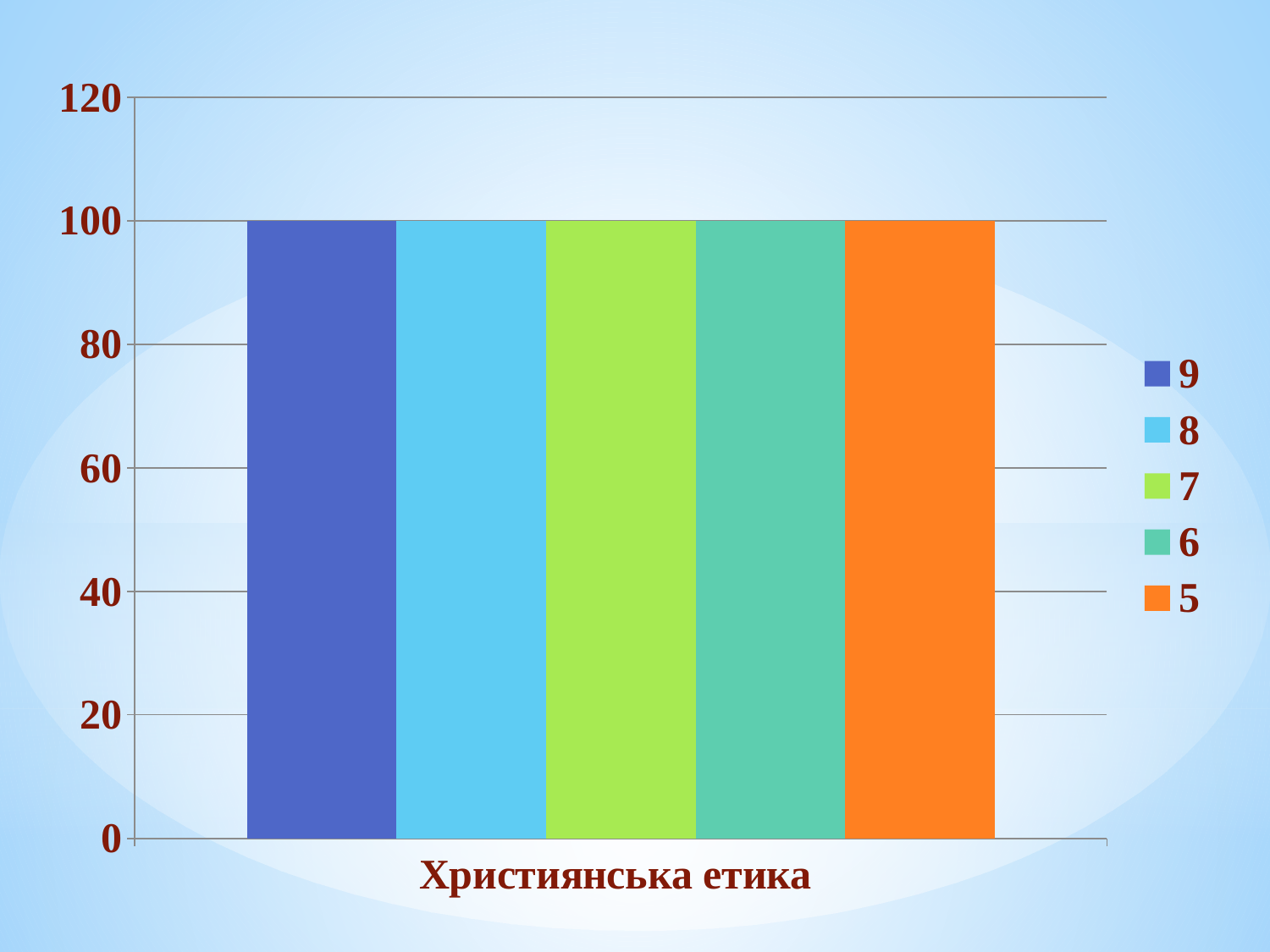
What is the value of series 7 for Християнська етика? 100 Which series is shown in orange? 5 What is the value of series 5 for Християнська етика? 100 What kind of chart is shown on the slide? bar chart Is the value for series 6 greater or less than 120? less What is the value of series 9 for Християнська етика? 100 What is the category label shown on the x axis? Християнська етика What is the difference between the values of series 9 and series 5? 0 How many categories are shown on the x axis? 1 Is the value for series 8 greater or less than 80? greater How many series does the legend list? 5